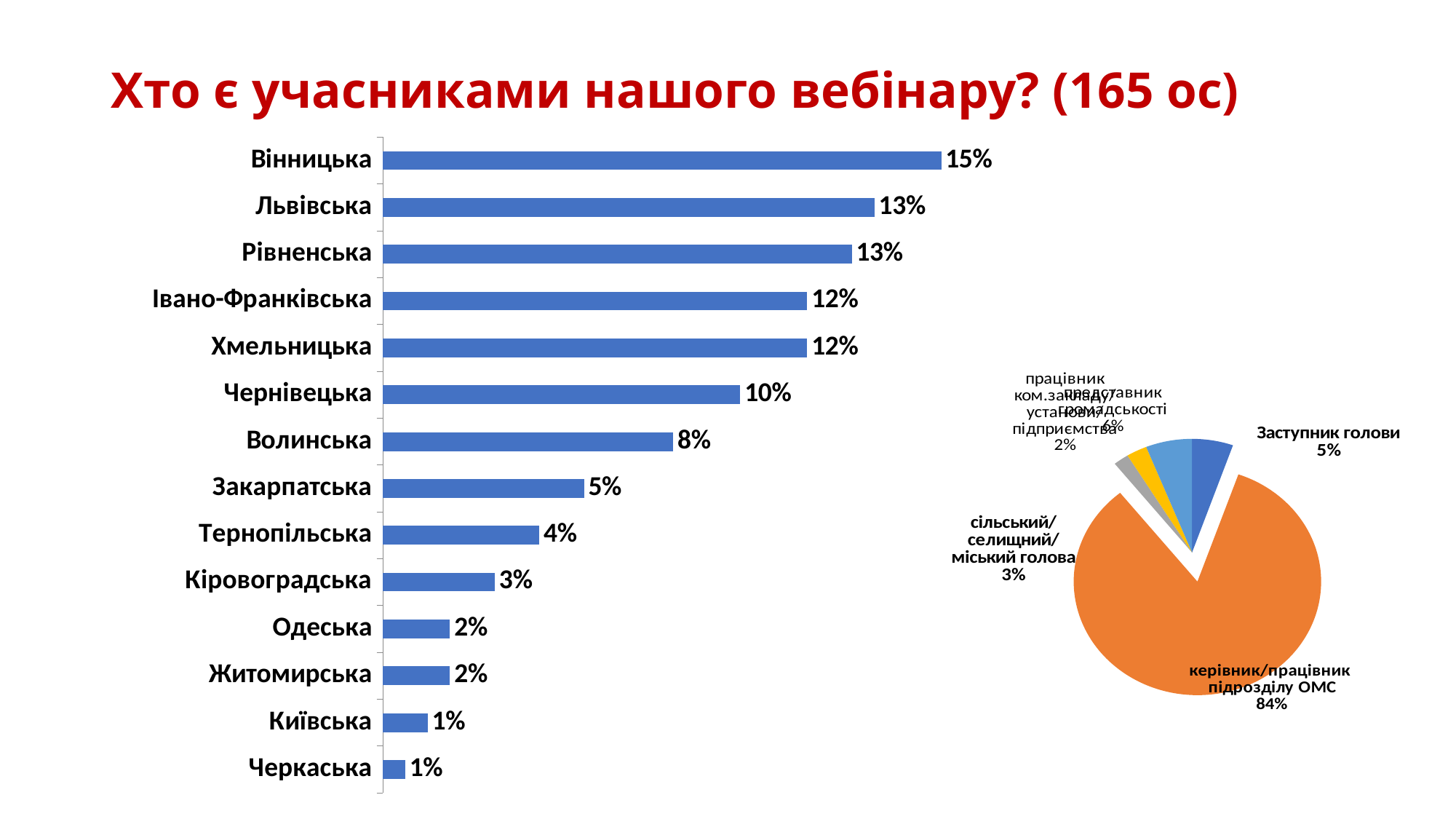
In the bar chart on the left, what is the value for Чернівецька? 10% In the bar chart on the left, which region has the highest value? Вінницька In the bar chart on the left, how many regions are shown? 14 In the pie chart on the right, what share does керівник/працівник підрозділу ОМС have? 84% In the pie chart on the right, what share does Заступник голови have? 5% In the bar chart on the left, do the values rise or fall going from the top bar to the bottom bar? Fall In the bar chart on the left, what is the value for Закарпатська? 5% What kind of chart is the chart on the right? Pie chart In the bar chart on the left, which is larger: the value for Хмельницька or the value for Тернопільська? Хмельницька In the bar chart on the left, what is the value for Вінницька? 15% What kind of chart is the chart on the left? Bar chart In the bar chart on the left, what is the difference between the values for Вінницька and Волинська? 7%